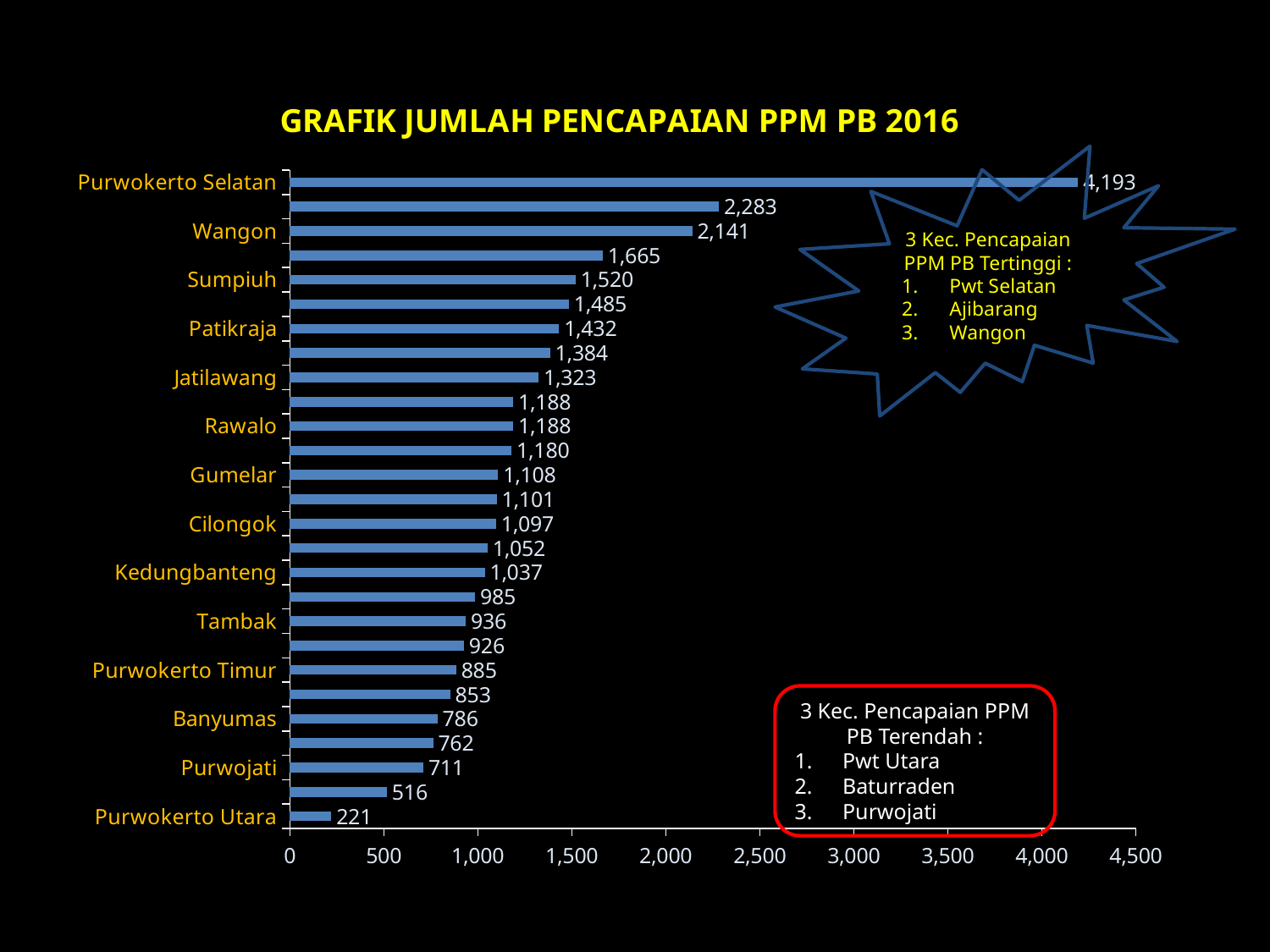
What is the value for Purwokerto Utara? 221 What is the value for Kedungbanteng? 1,037 Which category has the highest value? Purwokerto Selatan What is the difference between the values for Purwokerto Selatan and Wangon? 2,052 What is the value for Wangon? 2,141 What is the title of the chart? GRAFIK JUMLAH PENCAPAIAN PPM PB 2016 How many bars are plotted in the chart? 27 What kind of chart is shown on the slide? bar chart Which category has the lowest value? Purwokerto Utara What is the value for Purwokerto Selatan? 4,193 Is the value for Banyumas greater or less than 1,000? less Which is larger, the value for Sumpiuh or the value for Patikraja? Sumpiuh